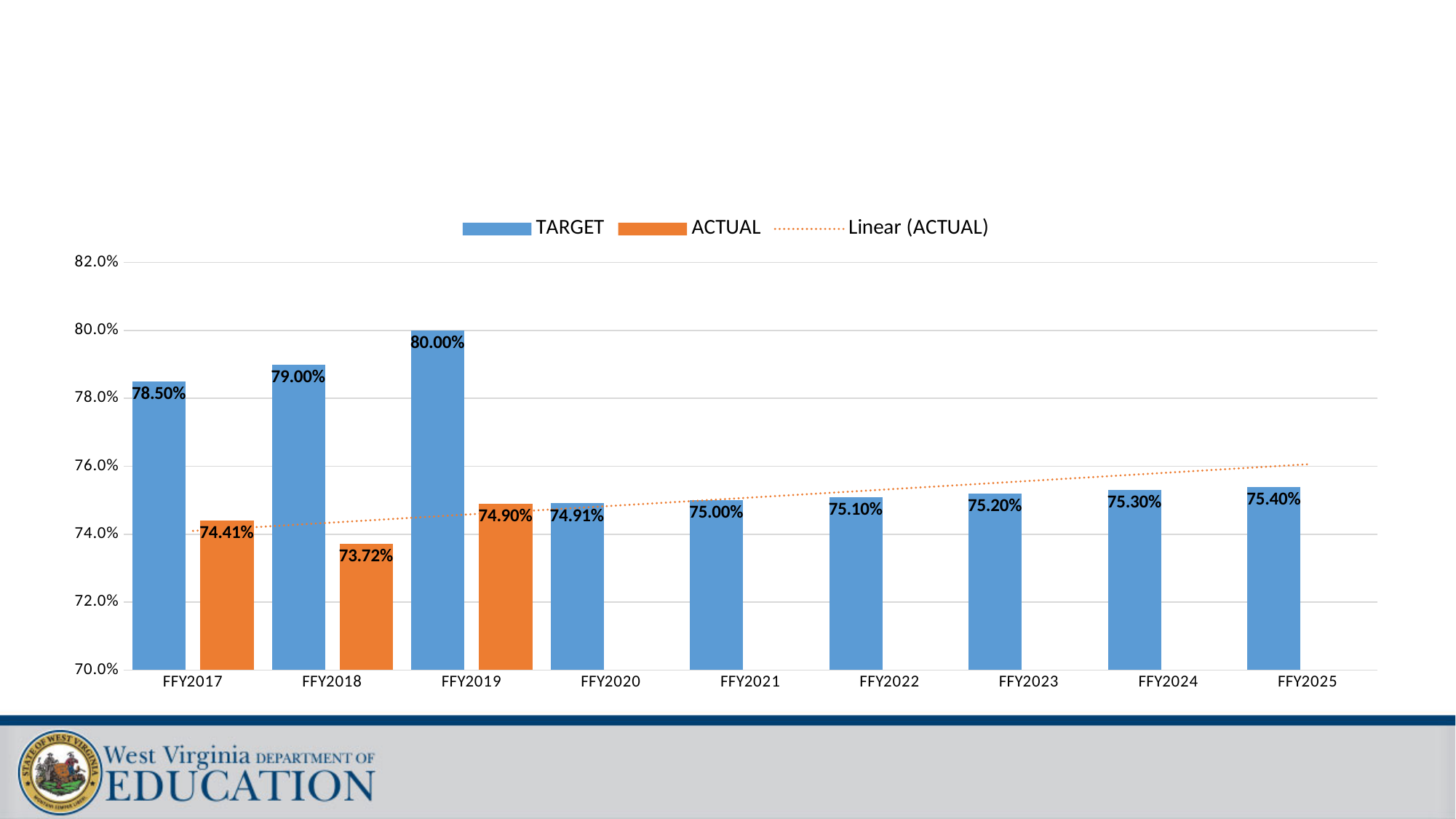
What is the TARGET value for FFY2019? 80.00% Which year has the highest TARGET value? FFY2019 Which is larger for FFY2017, the TARGET value or the ACTUAL value? TARGET What is the ACTUAL value for FFY2017? 74.41% What is the TARGET value for FFY2025? 75.40% How many entries does the legend list? 3 What is the difference between the TARGET and ACTUAL values for FFY2019? 5.10% Which year has the lowest ACTUAL value? FFY2018 How many years are shown on the x axis? 9 Is the TARGET value for FFY2020 greater or less than 76.0%? less What is the ACTUAL value for FFY2018? 73.72% What kind of chart is shown on the slide? bar chart